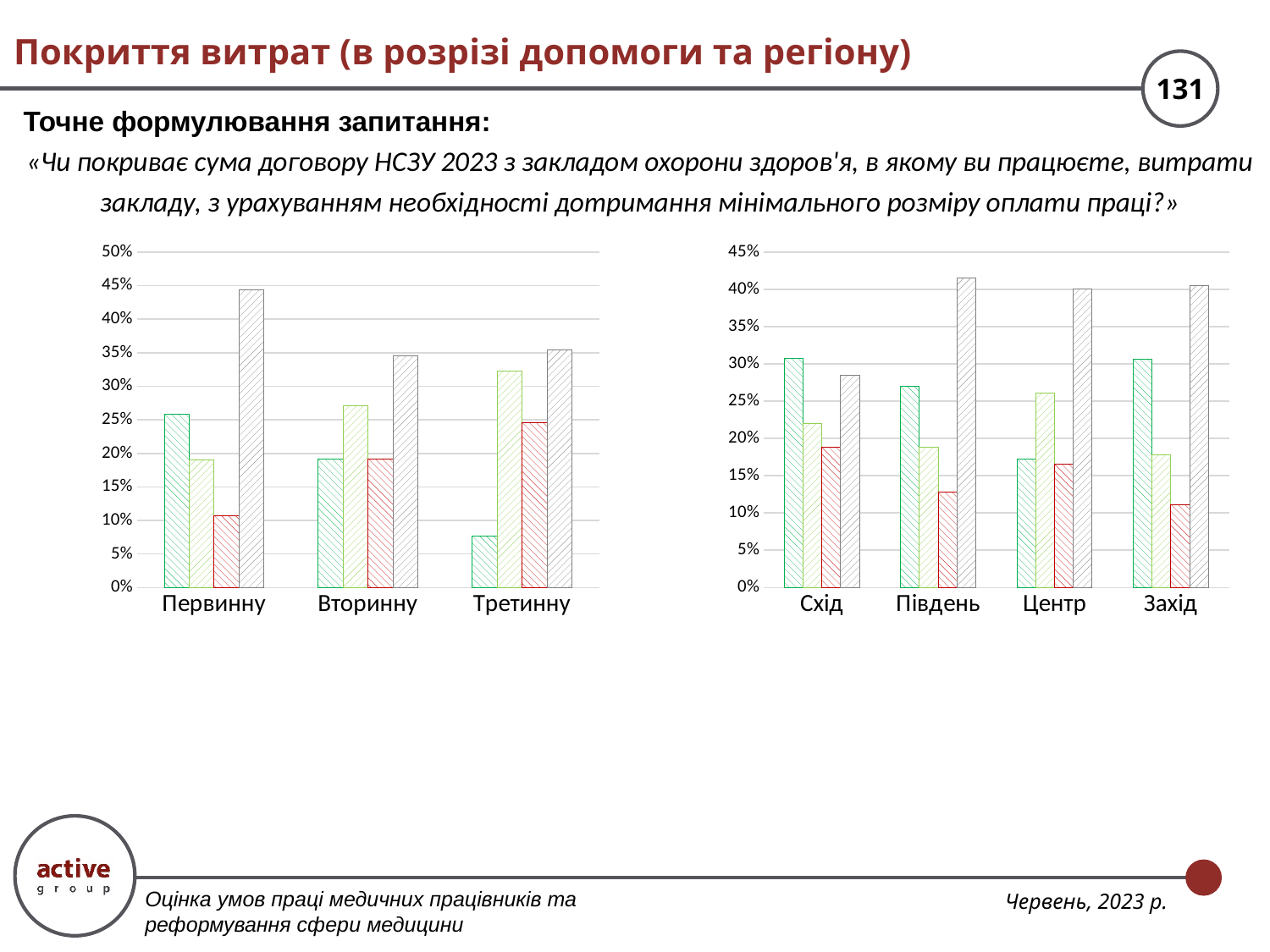
In the left chart, is the value of the grey hatched bar for Первинну greater or less than 40%? greater In the right chart, is the value of the red hatched bar for Захід greater or less than 15%? less In the left chart, is the value of the red hatched bar for Первинну greater or less than 15%? less In the left chart, which category has the tallest grey hatched bar? Первинну What is the highest value shown on the y axis of the right chart? 45% What is the highest value shown on the y axis of the left chart? 50% How many categories are shown on the x axis of the right chart (Схід, Південь, Центр, Захід)? 4 In the left chart, how many bars are plotted for each category? 4 How many categories are shown on the x axis of the left chart? 3 In the right chart, which category has the lowest grey hatched bar? Схід What kind of chart is the left chart (Первинну, Вторинну, Третинну)? bar chart